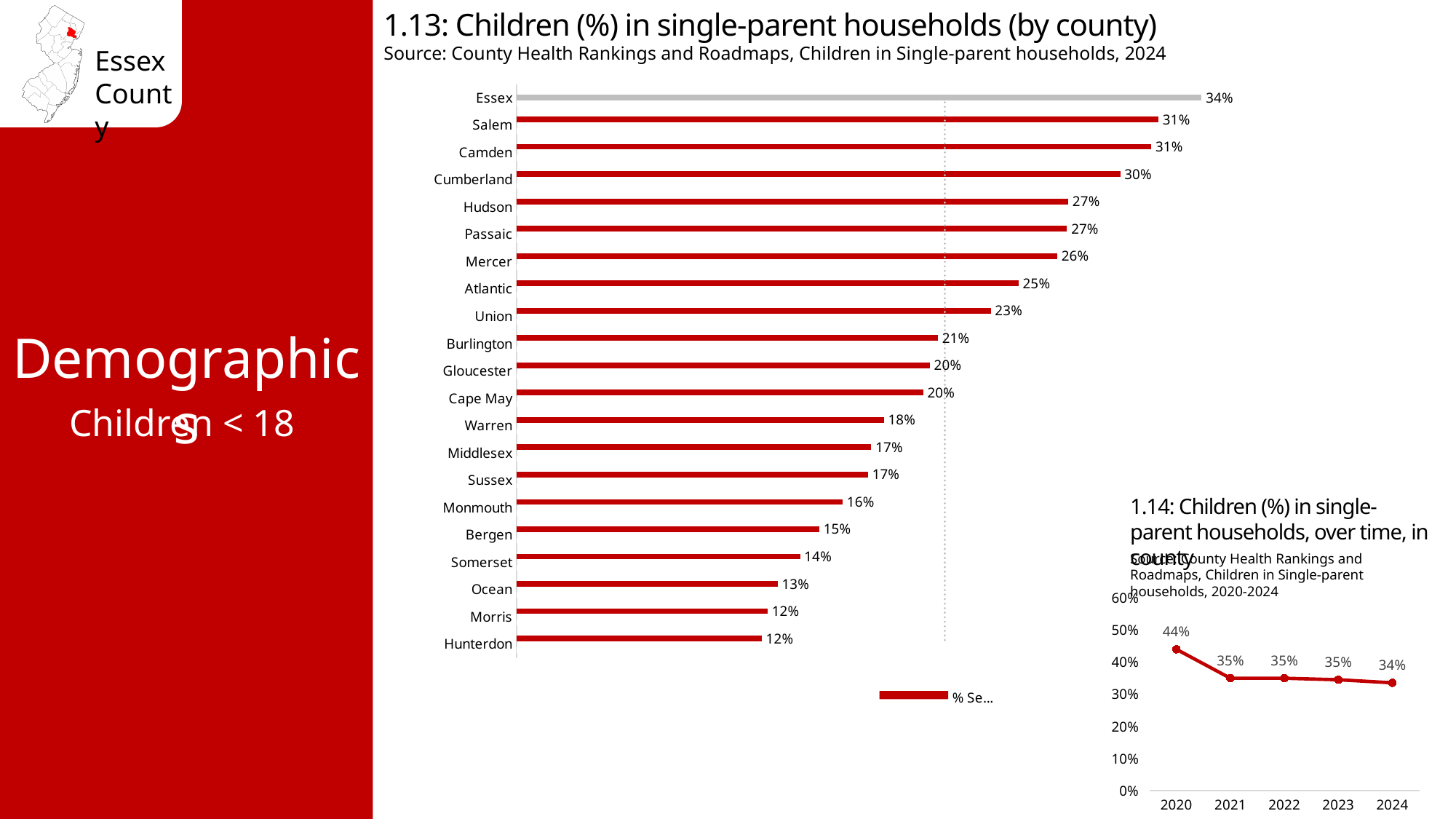
In chart 1.13 (Children (%) in single-parent households by county), which is larger, the value for Union or the value for Bergen? Union In chart 1.13 (Children (%) in single-parent households by county), what is the value for Hudson? 27% In chart 1.14 (Children (%) in single-parent households over time), do the values rise or fall from 2020 to 2024? Fall What kind of chart is chart 1.14 (Children (%) in single-parent households over time)? Line chart In chart 1.13 (Children (%) in single-parent households by county), what is the value for Monmouth? 16% In chart 1.13 (Children (%) in single-parent households by county), what is the value for Essex? 34% In chart 1.14 (Children (%) in single-parent households over time), which year has the lowest value? 2024 In chart 1.13 (Children (%) in single-parent households by county), how many counties are shown? 21 In chart 1.13 (Children (%) in single-parent households by county), which county has the highest value? Essex In chart 1.14 (Children (%) in single-parent households over time), what is the value for 2020? 44% What kind of chart is chart 1.13 (Children (%) in single-parent households by county)? Bar chart In chart 1.13 (Children (%) in single-parent households by county), what is the difference between Essex and Cumberland? 4%